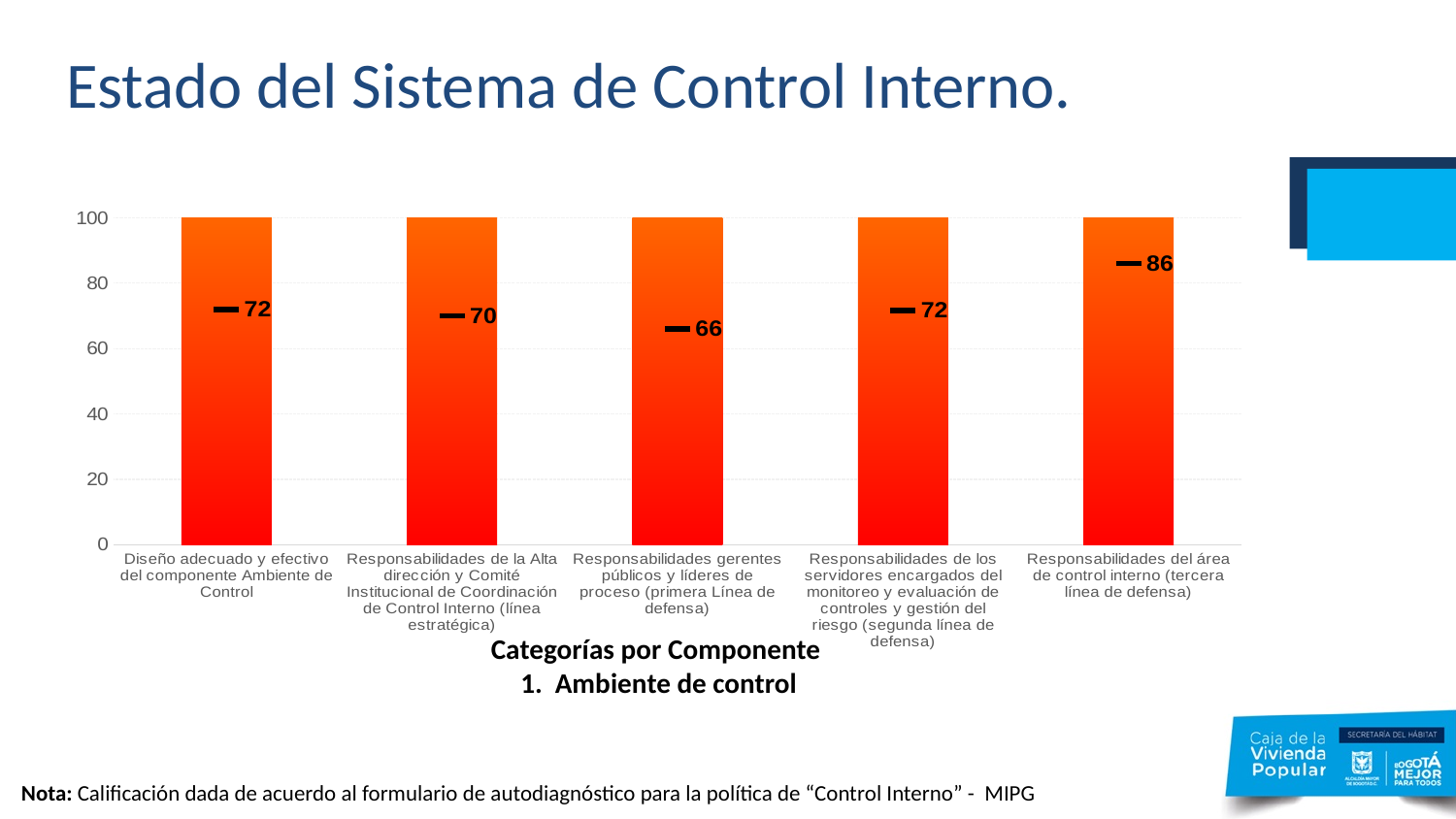
Which category has the lowest value? Responsabilidades gerentes públicos y líderes de proceso (primera Línea de defensa) What is the title of the slide containing the chart? Estado del Sistema de Control Interno. How many categories are shown on the x axis of the chart? 5 What kind of chart is shown on the slide? bar chart Which category has the highest value? Responsabilidades del área de control interno (tercera línea de defensa) What is the value shown for "Diseño adecuado y efectivo del componente Ambiente de Control"? 72 Which is larger: the value for "Responsabilidades de los servidores encargados del monitoreo y evaluación de controles y gestión del riesgo (segunda línea de defensa)" or the value for "Responsabilidades del área de control interno (tercera línea de defensa)"? Responsabilidades del área de control interno (tercera línea de defensa) What is the value shown for "Responsabilidades gerentes públicos y líderes de proceso (primera Línea de defensa)"? 66 What is the value shown for "Responsabilidades del área de control interno (tercera línea de defensa)"? 86 What is the value shown for "Responsabilidades de la Alta dirección y Comité Institucional de Coordinación de Control Interno (línea estratégica)"? 70 What is the difference between the highest value (86) and the lowest value (66)? 20 Is the value for "Responsabilidades del área de control interno (tercera línea de defensa)" greater or less than 80? greater